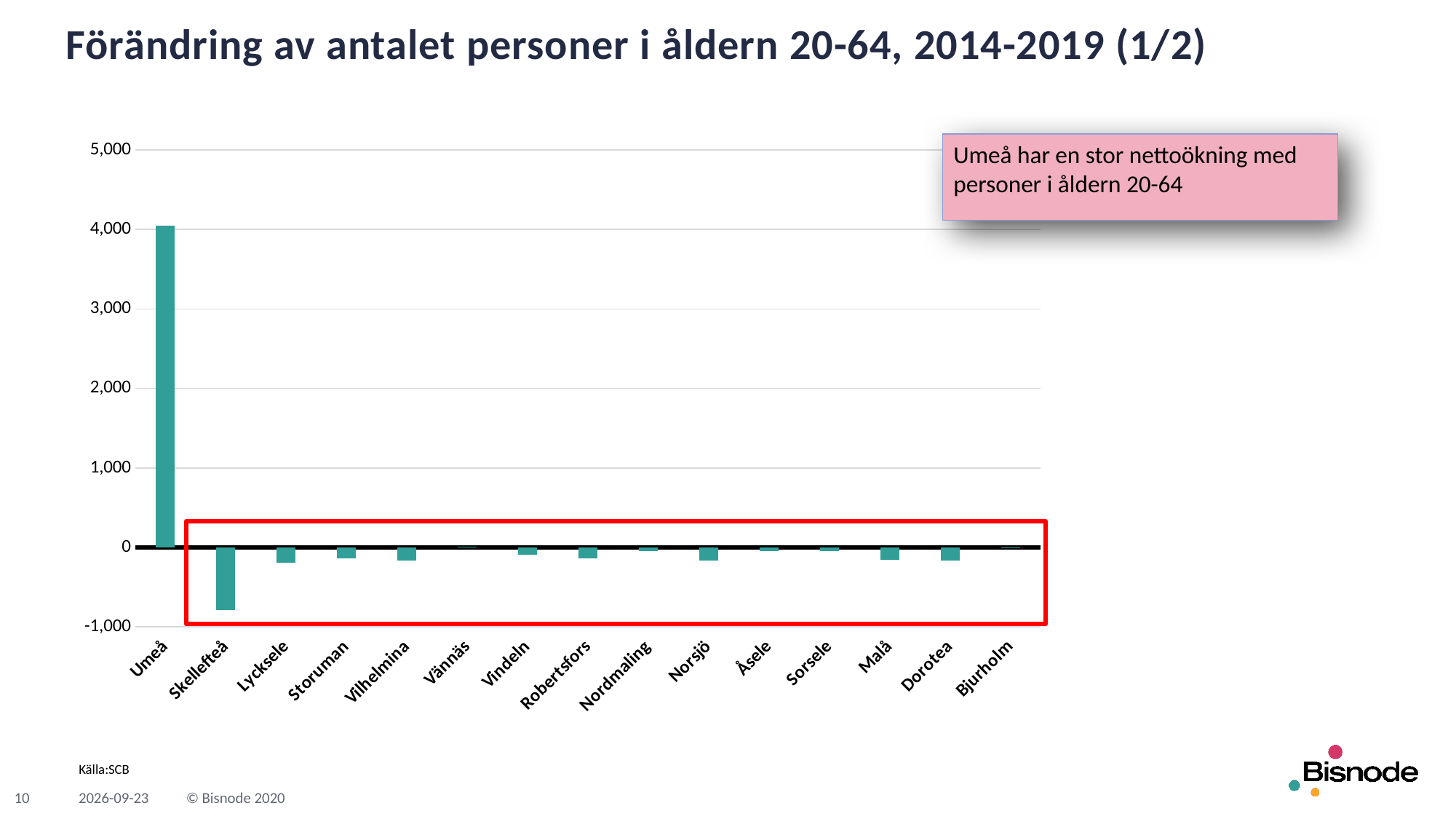
Is the value for Lycksele greater or less than 0? less Which municipality has the lowest value in the chart? Skellefteå What source is cited for the chart data? SCB What is the title of the slide? Förändring av antalet personer i åldern 20-64, 2014-2019 (1/2) Which municipality has the highest value in the chart? Umeå Which has the larger value, Umeå or Skellefteå? Umeå What kind of chart is shown on the slide? bar chart Is the value for Umeå greater or less than 3,000? greater Which has the larger value, Vännäs or Skellefteå? Vännäs Is the value for Umeå greater or less than 1,000? greater How many municipalities are shown on the x axis of the chart? 15